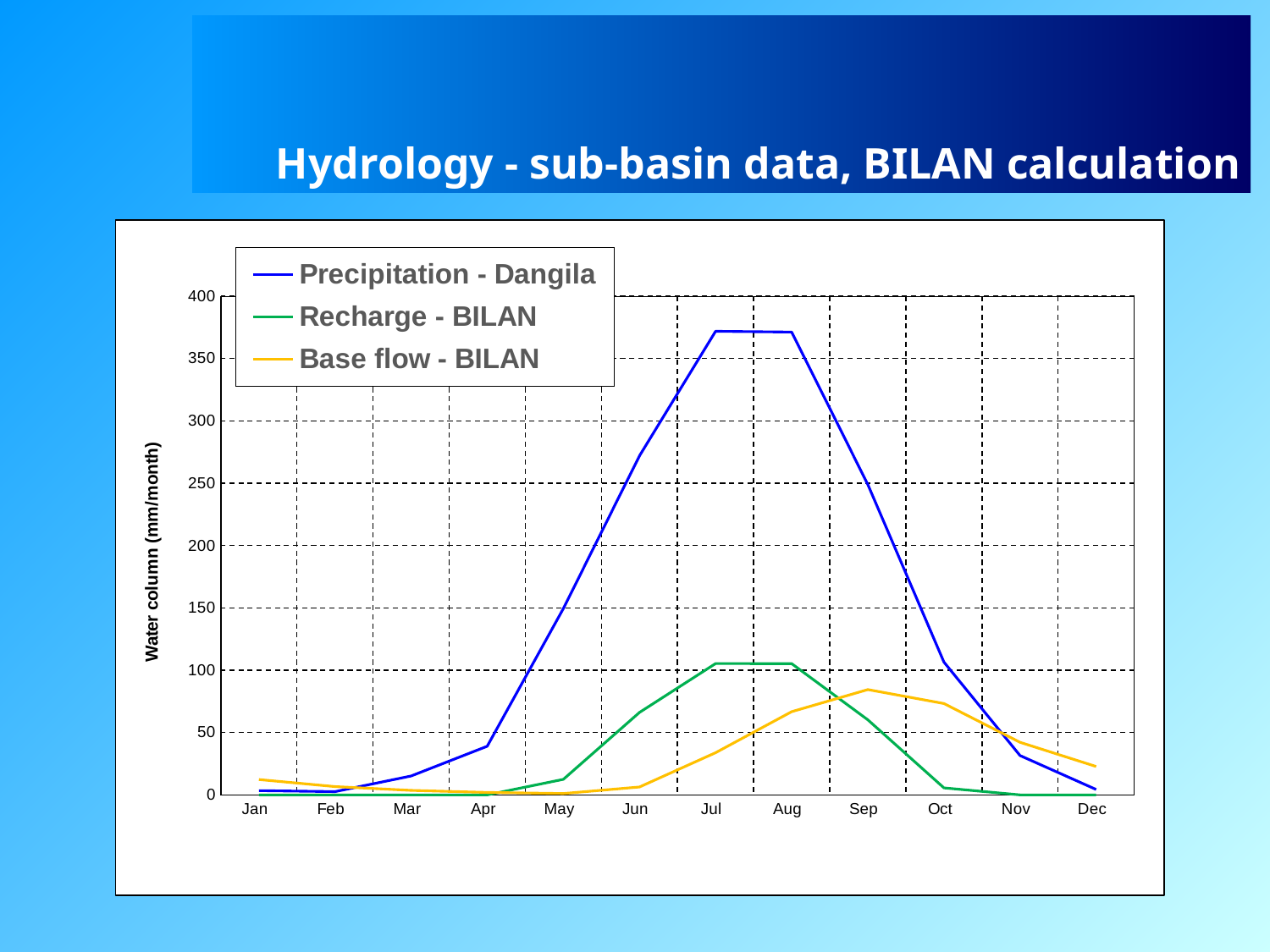
What is the label of the y axis? Water column (mm/month) Which series is drawn in green? Recharge - BILAN Is the value for Base flow - BILAN in Sep greater or less than 100? less How many series does the legend list? 3 In which month does Base flow - BILAN reach its highest value? Sep Does Precipitation - Dangila rise or fall from Aug to Dec? fall Is the value for Precipitation - Dangila in Apr greater or less than 50? less Is the value for Recharge - BILAN in Aug greater or less than 100? greater What kind of chart is shown on the slide? line chart How many months are plotted along the x axis? 12 In Jul, which is larger: Precipitation - Dangila or Recharge - BILAN? Precipitation - Dangila